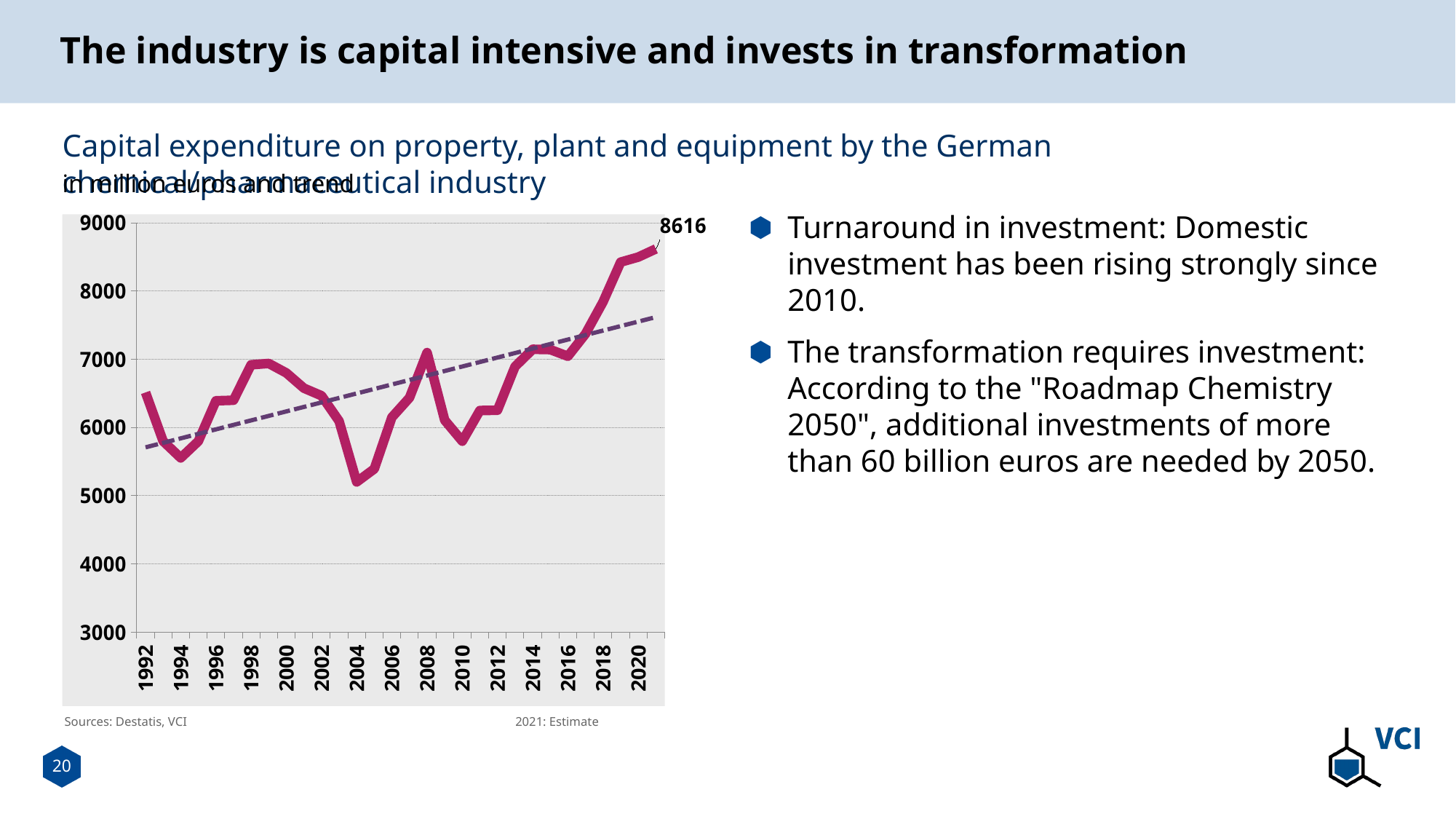
In which year does the line reach its highest value? 2021 What kind of chart is shown on the slide? line chart Is the value for 1994 greater or less than 6000? less Is the value for 2018 greater or less than 8000? less What is the highest value shown on the y axis? 9000 In which year does the line reach its lowest value? 2004 Does the dashed trend line rise or fall from 1992 to 2021? rise Is the value for 1992 greater or less than 6000? greater What is the capital expenditure value labelled for 2021 at the end of the line? 8616 Which year has the larger value, 2004 or 2010? 2010 What sources are cited below the chart? Destatis, VCI